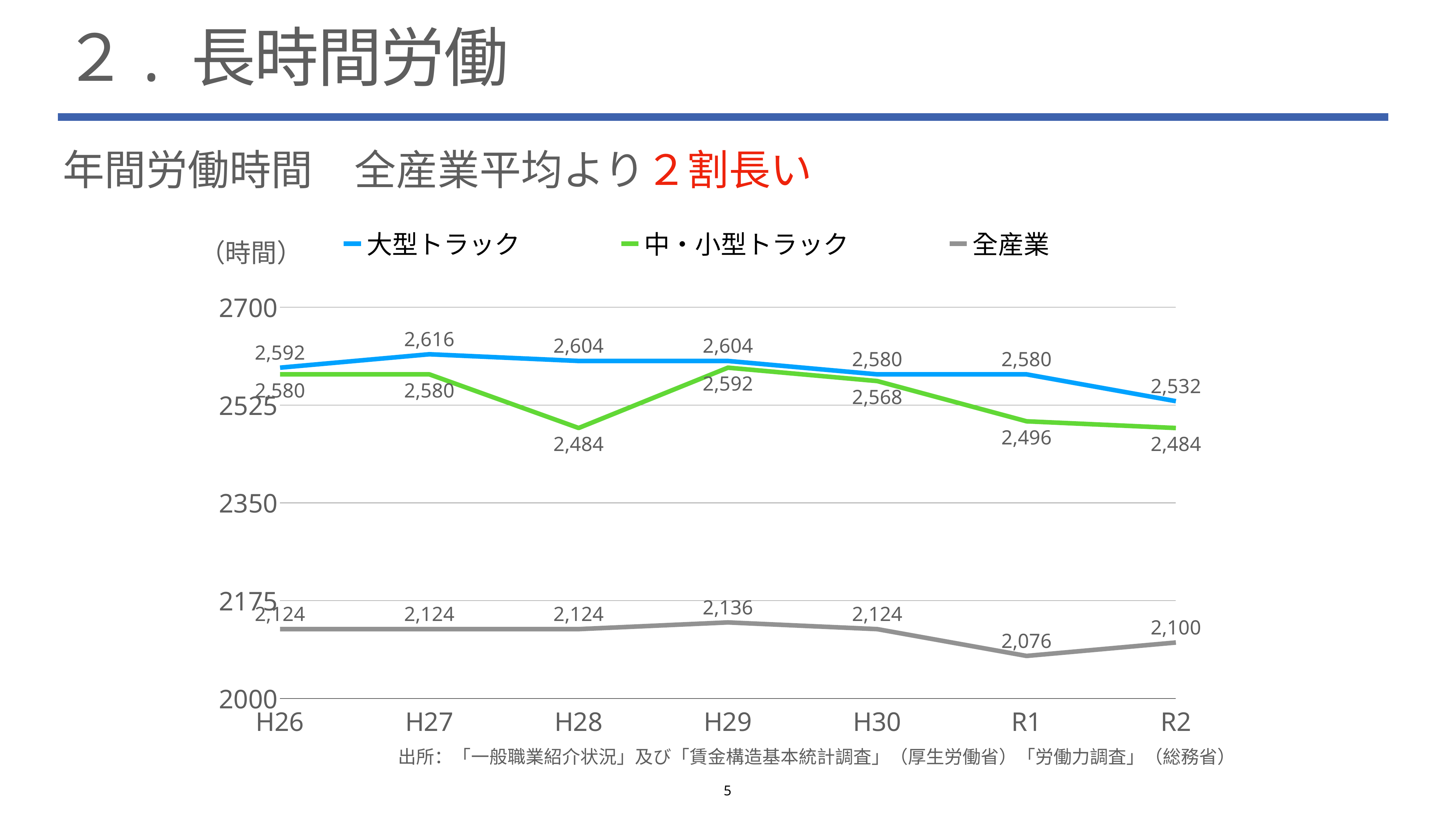
What is the value for 全産業 in R1? 2,076 In which year is the value for 全産業 lowest? R1 What is the value for 中・小型トラック in H28? 2,484 What is the difference between 大型トラック and 全産業 in R2? 432 Which is larger in H29: 大型トラック or 中・小型トラック? 大型トラック In which year is the value for 大型トラック highest? H27 How many points along the x axis does the chart show? 7 How many series does the legend list? 3 Does the value for 大型トラック rise or fall from H30 to R2? fall Which series is drawn in green? 中・小型トラック What type of chart is shown on the slide? line chart What is the value for 大型トラック in H27? 2,616